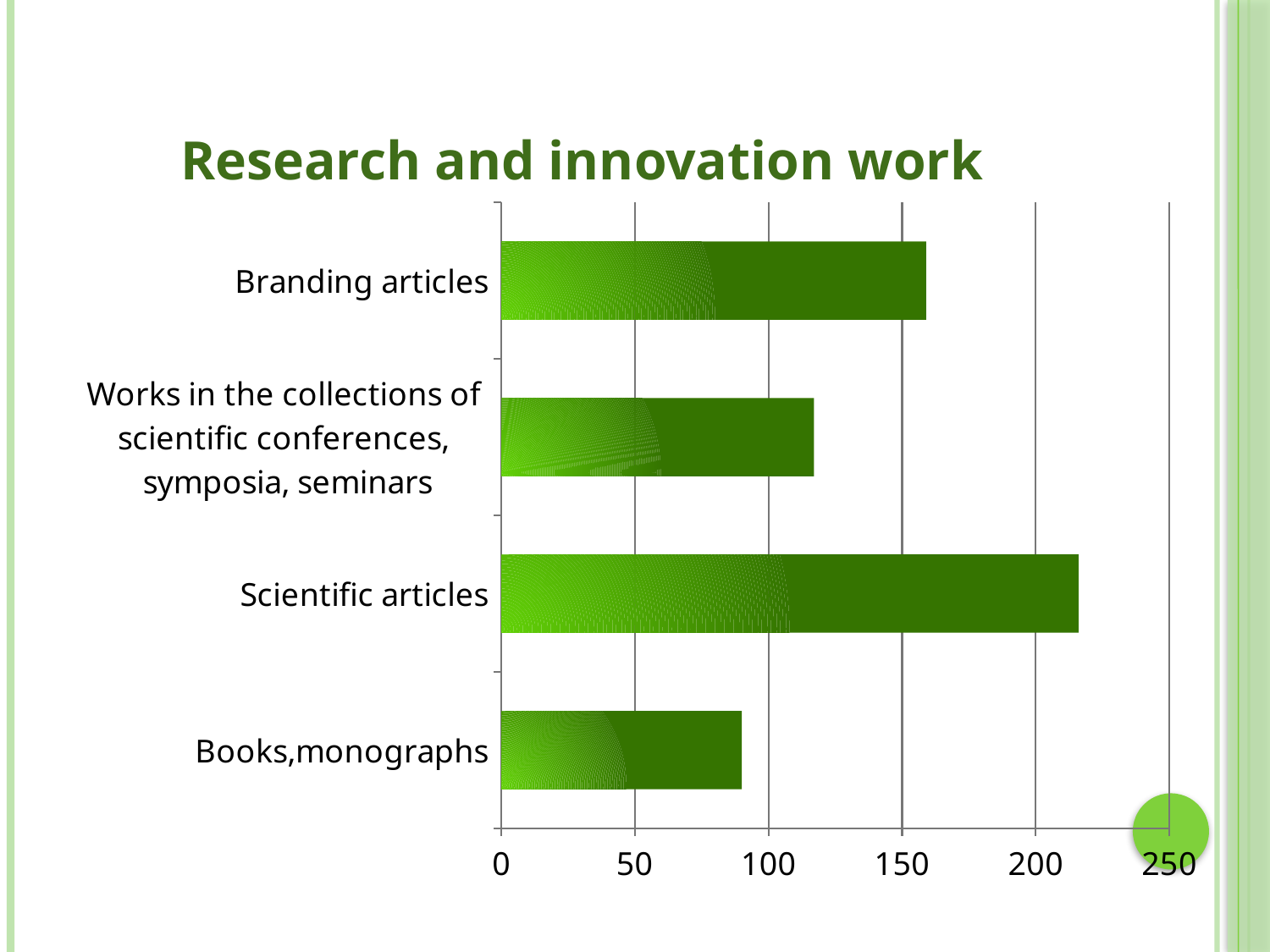
Is the value for Books,monographs greater or less than 100? less Which is larger, the value for Branding articles or the value for Works in the collections of scientific conferences, symposia, seminars? Branding articles Which is larger, the value for Scientific articles or the value for Books,monographs? Scientific articles Which category has the lowest value? Books,monographs Which category has the highest value? Scientific articles Is the value for Branding articles greater or less than 100? greater What is the title of the chart? Research and innovation work How many categories are shown in the chart? 4 Is the value for Branding articles greater or less than 200? less What kind of chart is shown on the slide? bar chart